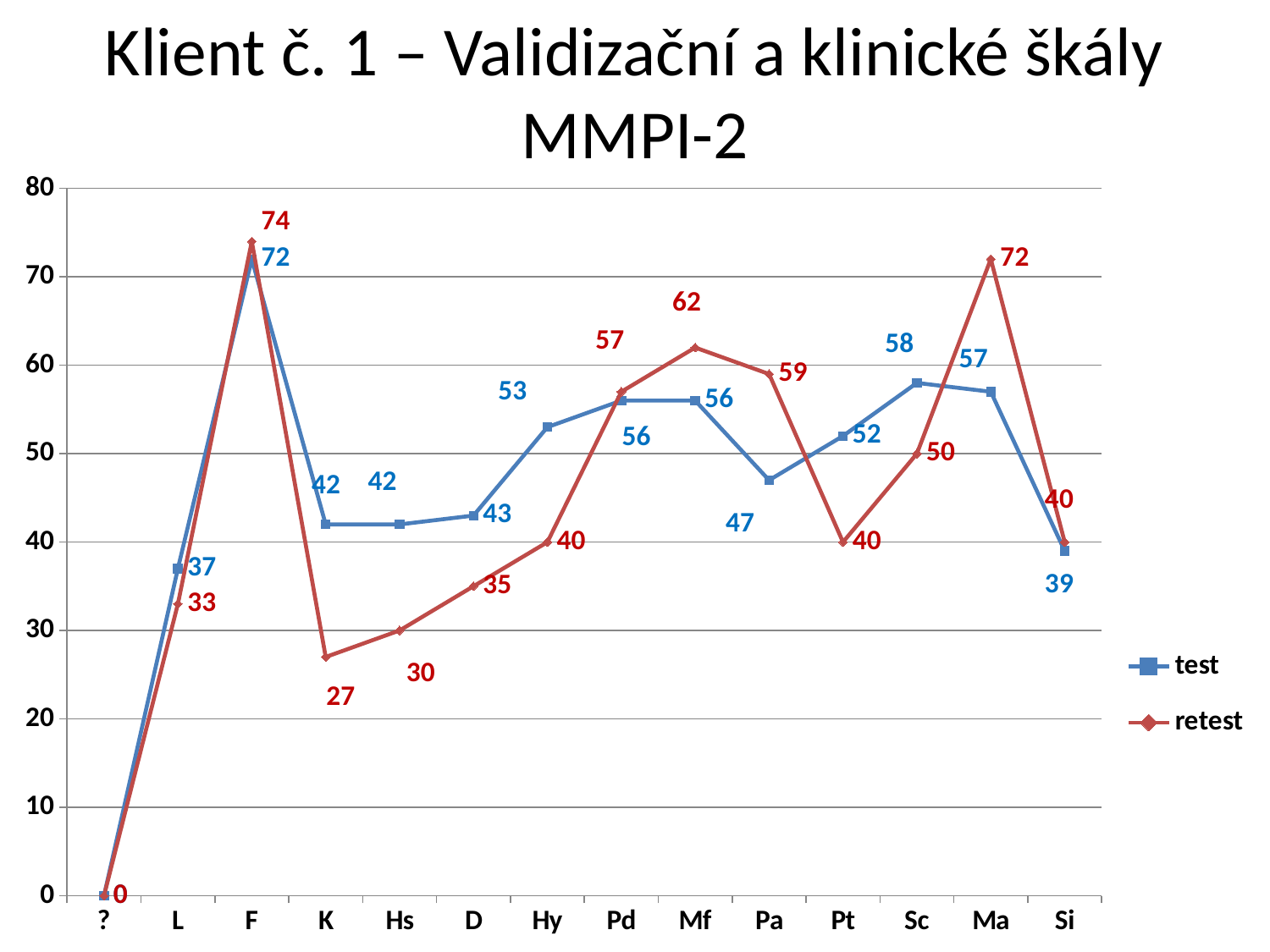
What is the difference between the test and retest values for K? 15 What kind of chart is shown on the slide? line chart What is the test value for Sc? 58 How many categories are shown on the x axis? 14 What is the difference between the retest and test values for Ma? 15 What is the title of the chart? Klient č. 1 – Validizační a klinické škály MMPI-2 Which category has the lowest retest value? ? For Mf, which series has the larger value, test or retest? retest How many series does the legend list? 2 Which category has the highest retest value? F What is the retest value for Ma? 72 Is the test value for Pa greater or less than 50? less